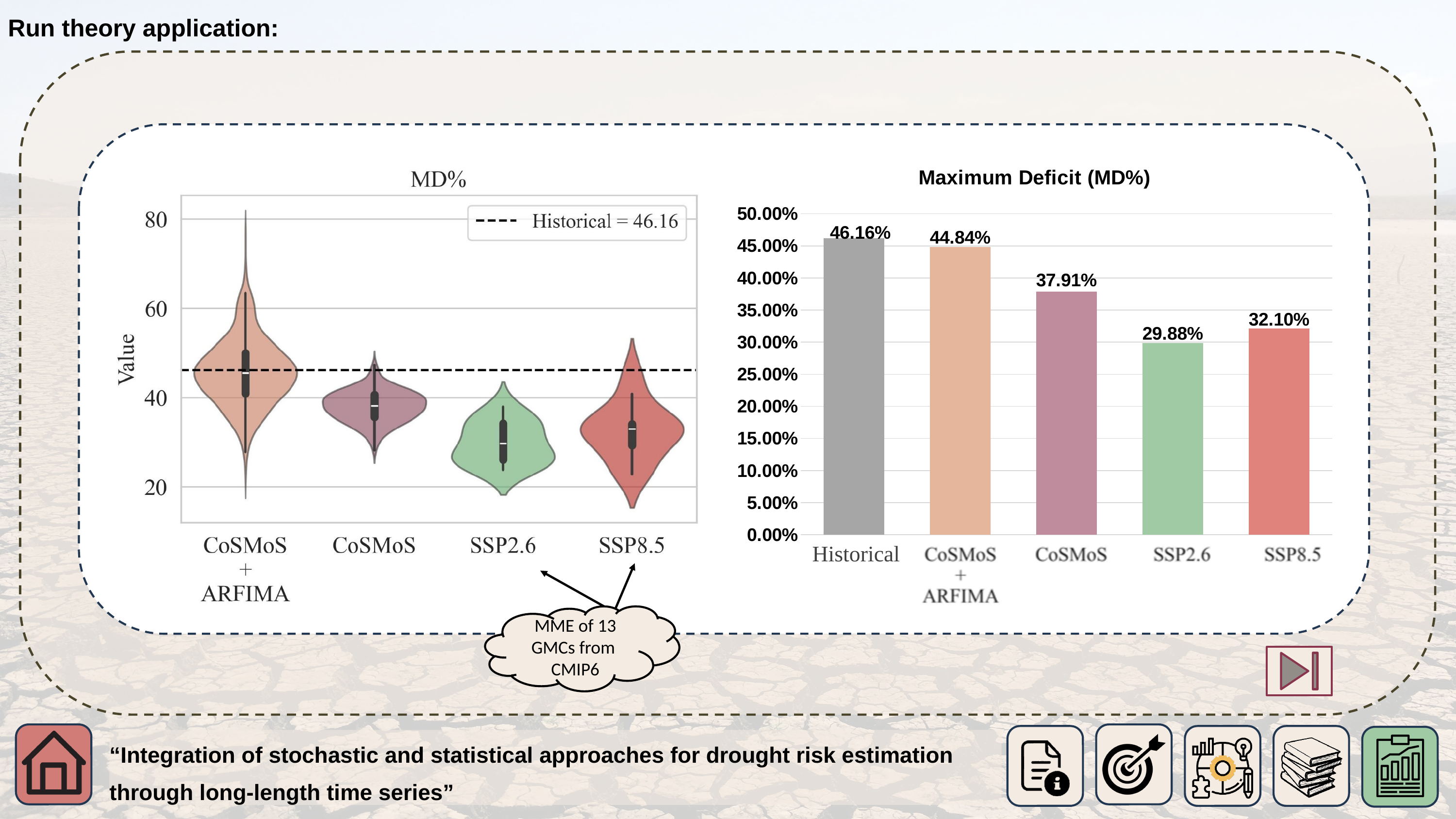
In the 'Maximum Deficit (MD%)' bar chart, how many bars are shown? 5 In the 'Maximum Deficit (MD%)' bar chart, is the value for CoSMoS + ARFIMA greater or less than 40.00%? greater In the 'Maximum Deficit (MD%)' bar chart, what is the value for Historical? 46.16% In the 'Maximum Deficit (MD%)' bar chart, what is the value for CoSMoS? 37.91% What kind of chart is the 'Maximum Deficit (MD%)' chart on the right? Bar chart In the 'Maximum Deficit (MD%)' bar chart, which category has the lowest value? SSP2.6 In the 'Maximum Deficit (MD%)' bar chart, what is the value for SSP2.6? 29.88% In the 'Maximum Deficit (MD%)' bar chart, what is the difference between the Historical value and the SSP8.5 value? 14.06% In the 'MD%' violin plot on the left, what Historical value does the dashed line represent according to the legend? 46.16 In the 'MD%' violin plot on the left, how many categories are shown on the x axis? 4 In the 'Maximum Deficit (MD%)' bar chart, which is larger: the value for SSP2.6 or the value for SSP8.5? SSP8.5 In the 'Maximum Deficit (MD%)' bar chart, which category has the highest value? Historical